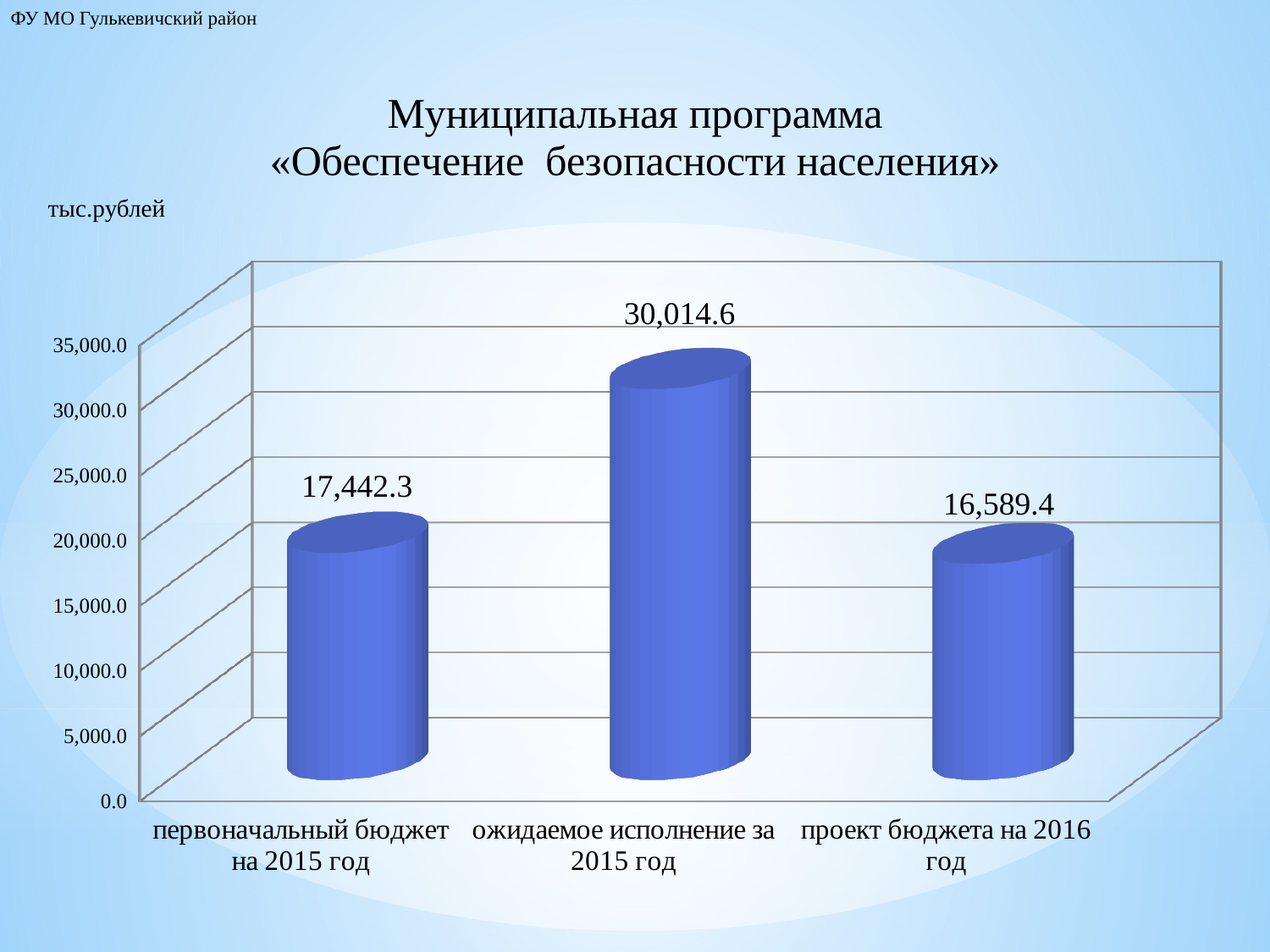
What is the value for «первоначальный бюджет на 2015 год»? 17,442.3 What is the difference between the values for «ожидаемое исполнение за 2015 год» and «первоначальный бюджет на 2015 год»? 12,572.3 Is the value for «ожидаемое исполнение за 2015 год» greater or less than 25,000.0? greater What kind of chart is shown on the slide? bar chart What unit of measurement is indicated above the chart? тыс.рублей Which category has the lowest value? проект бюджета на 2016 год Which category has the highest value? ожидаемое исполнение за 2015 год What is the value for «проект бюджета на 2016 год»? 16,589.4 Which is larger: the value for «первоначальный бюджет на 2015 год» or for «проект бюджета на 2016 год»? первоначальный бюджет на 2015 год What is the value for «ожидаемое исполнение за 2015 год»? 30,014.6 What is the difference between the values for «первоначальный бюджет на 2015 год» and «проект бюджета на 2016 год»? 852.9 How many categories are shown in the chart? 3